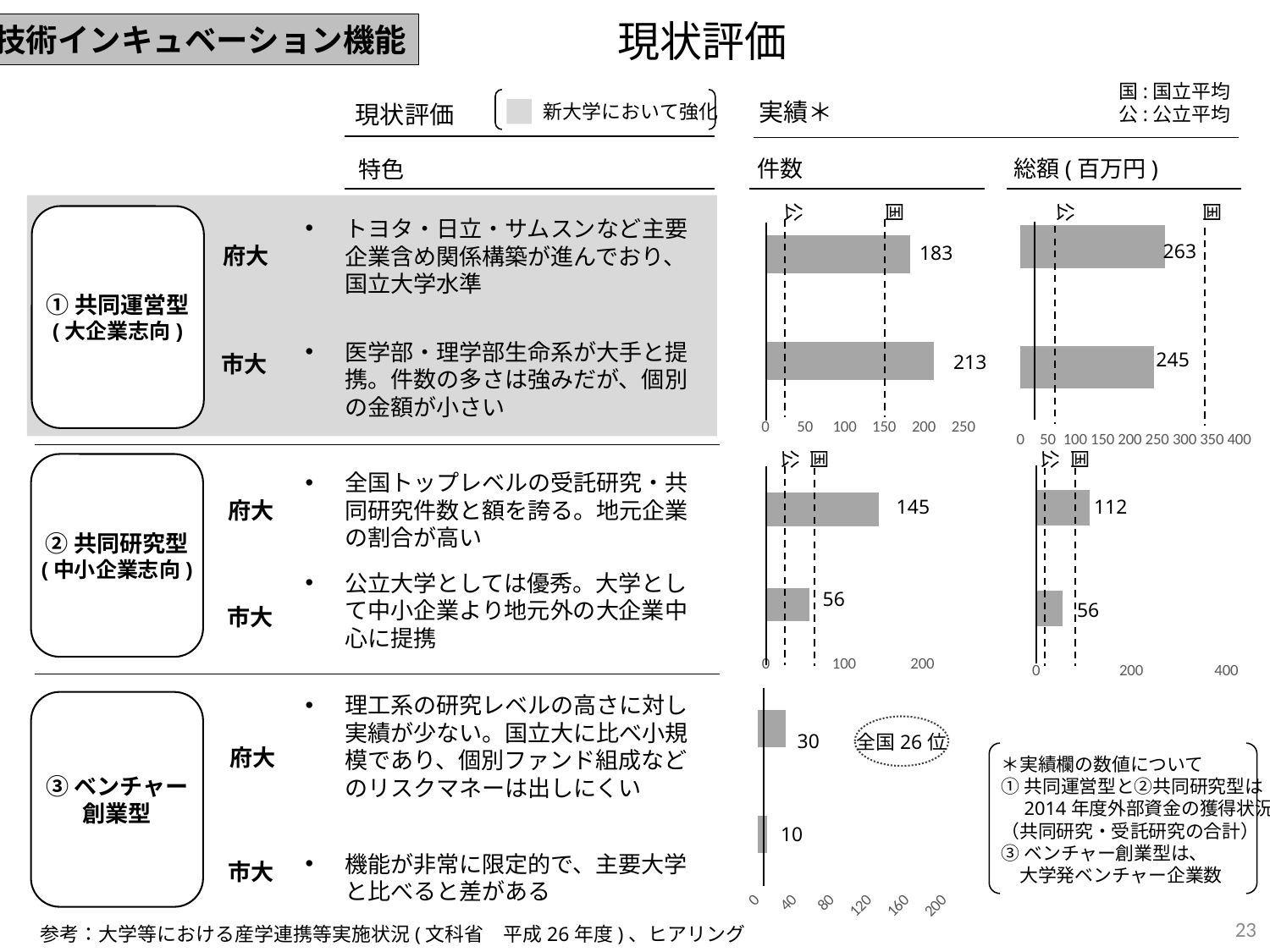
In the ②共同研究型 総額(百万円) chart, what is the value for 府大? 112 In the ③ベンチャー創業型 件数 chart, which university has the lowest value? 市大 In the ③ベンチャー創業型 件数 chart, what is the value for 府大? 30 In the ①共同運営型 件数 chart, is the value for 市大 greater or less than 200? greater What type of chart is used in the 実績 section of the slide? bar chart In the ①共同運営型 件数 chart, what is the value for 府大? 183 In the ②共同研究型 件数 chart, which university has the higher value, 府大 or 市大? 府大 In the ②共同研究型 件数 chart, what is the difference between 府大 and 市大? 89 In the ①共同運営型 件数 chart, what is the value for 市大? 213 In the ②共同研究型 総額(百万円) chart, what is the value for 市大? 56 In the ①共同運営型 総額(百万円) chart, what is the difference between 府大 and 市大? 18 In the ①共同運営型 総額(百万円) chart, what is the value for 府大? 263